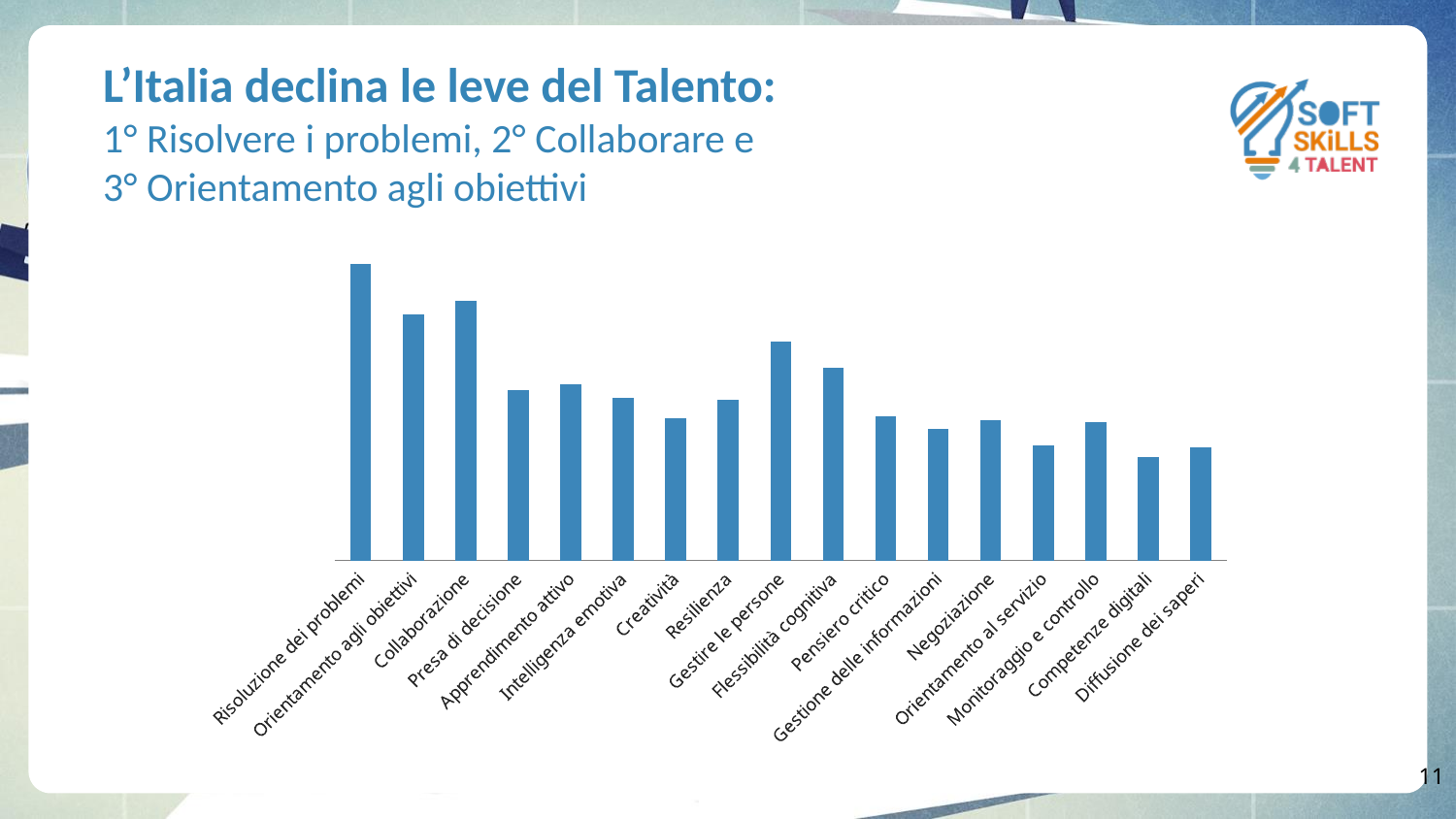
Which bar is taller, Creatività or Resilienza? Resilienza What kind of chart is shown on the slide? bar chart Which category has the lowest bar in the chart? Competenze digitali Which bar is taller, Pensiero critico or Gestione delle informazioni? Pensiero critico Which bar is taller, Gestire le persone or Flessibilità cognitiva? Gestire le persone What is the first category on the left of the x axis? Risoluzione dei problemi Do the bar heights generally rise or fall from left to right across the chart? fall Which category has the highest bar in the chart? Risoluzione dei problemi How many categories are plotted in the chart? 17 What colour are the bars in the chart? blue